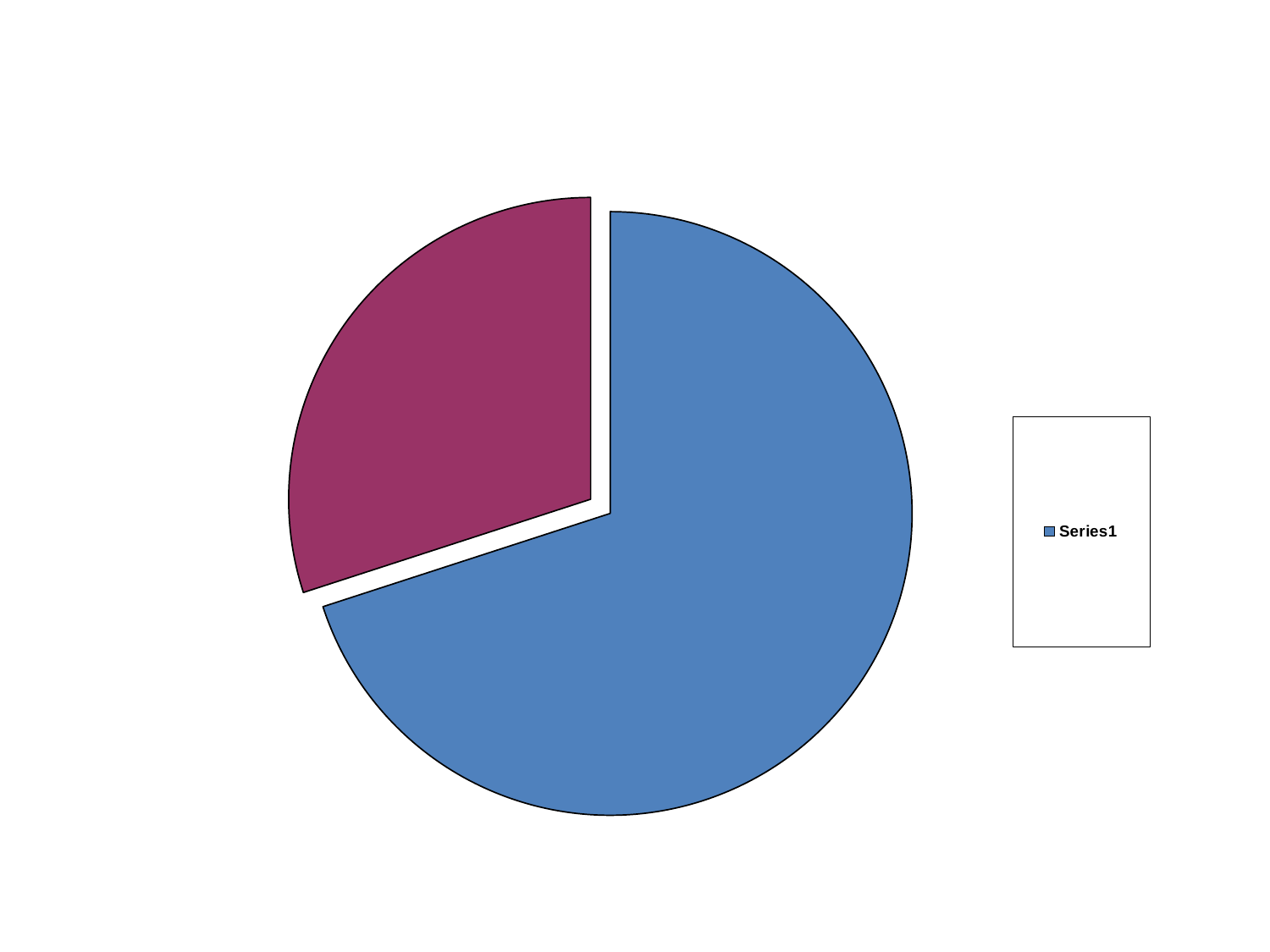
How many series does the legend list? 1 What kind of chart is shown on the slide? pie chart How many slices does the pie chart have? 2 Which slice is pulled out (exploded) from the rest of the pie? the purple slice Which slice of the pie chart is the largest? the blue slice Which slice of the pie chart is the smallest? the purple slice What is the name of the series listed in the legend? Series1 Which slice is larger, the blue slice or the purple slice? the blue slice